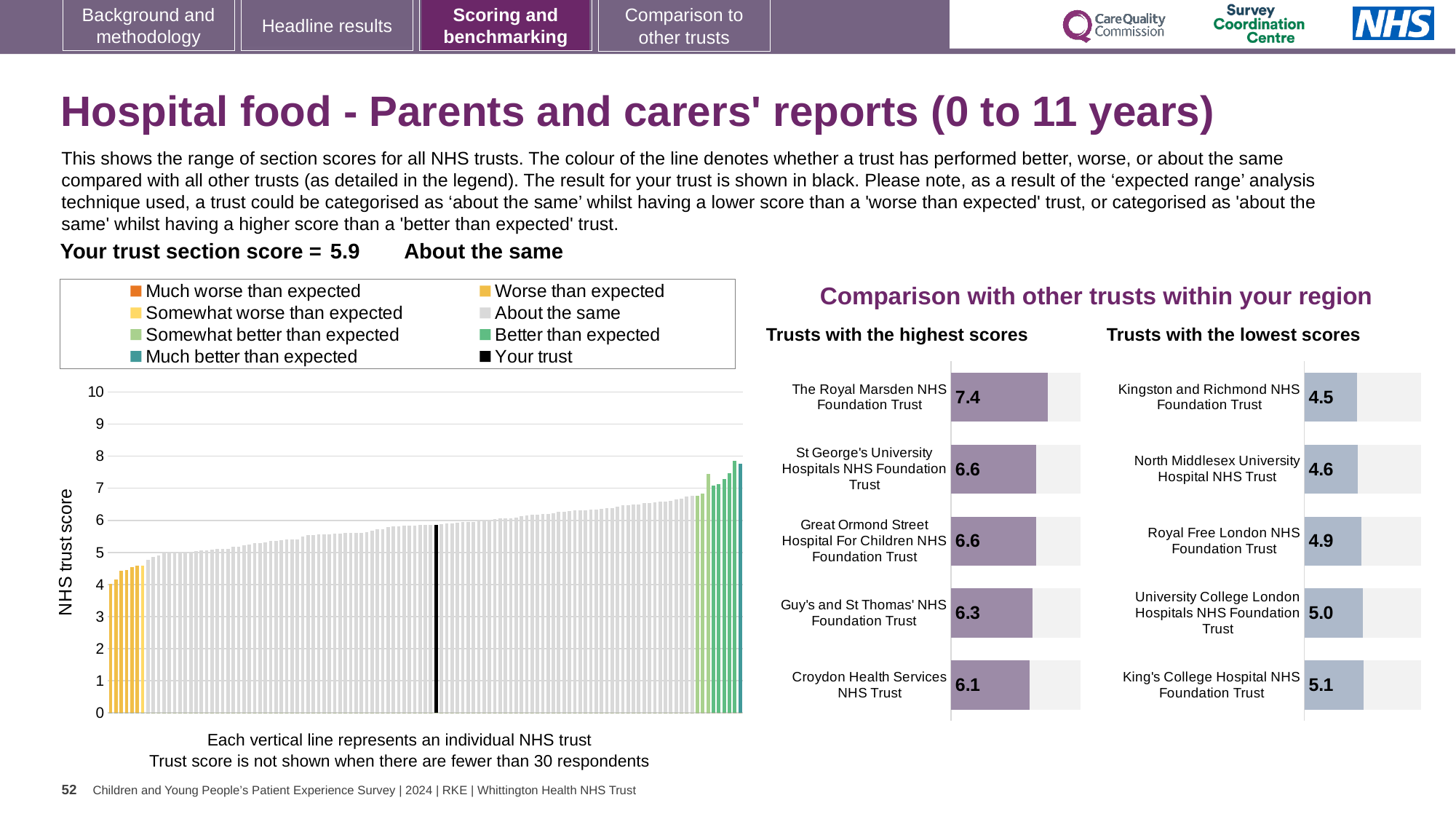
How many trusts are shown in the 'Trusts with the lowest scores' chart? 5 How many entries does the legend of the large chart of all NHS trusts list? 8 In the 'Trusts with the lowest scores' chart, which has the higher score: University College London Hospitals NHS Foundation Trust or North Middlesex University Hospital NHS Trust? University College London Hospitals NHS Foundation Trust In the large chart of all NHS trusts, what is the section score for your trust (the black bar)? 5.9 In the 'Trusts with the highest scores' chart, what is the score for Croydon Health Services NHS Trust? 6.1 In the 'Trusts with the highest scores' chart, what is the difference between the scores of The Royal Marsden NHS Foundation Trust and Croydon Health Services NHS Trust? 1.3 In the 'Trusts with the highest scores' chart, which trust has the highest score? The Royal Marsden NHS Foundation Trust In the 'Trusts with the lowest scores' chart, which trust has the lowest score? Kingston and Richmond NHS Foundation Trust In the 'Trusts with the highest scores' chart, what is the score for The Royal Marsden NHS Foundation Trust? 7.4 In the large chart of all NHS trusts, do the bar values rise or fall from left to right? rise In the 'Trusts with the lowest scores' chart, what is the score for Royal Free London NHS Foundation Trust? 4.9 In the 'Trusts with the lowest scores' chart, what is the difference between the scores of King's College Hospital NHS Foundation Trust and Kingston and Richmond NHS Foundation Trust? 0.6